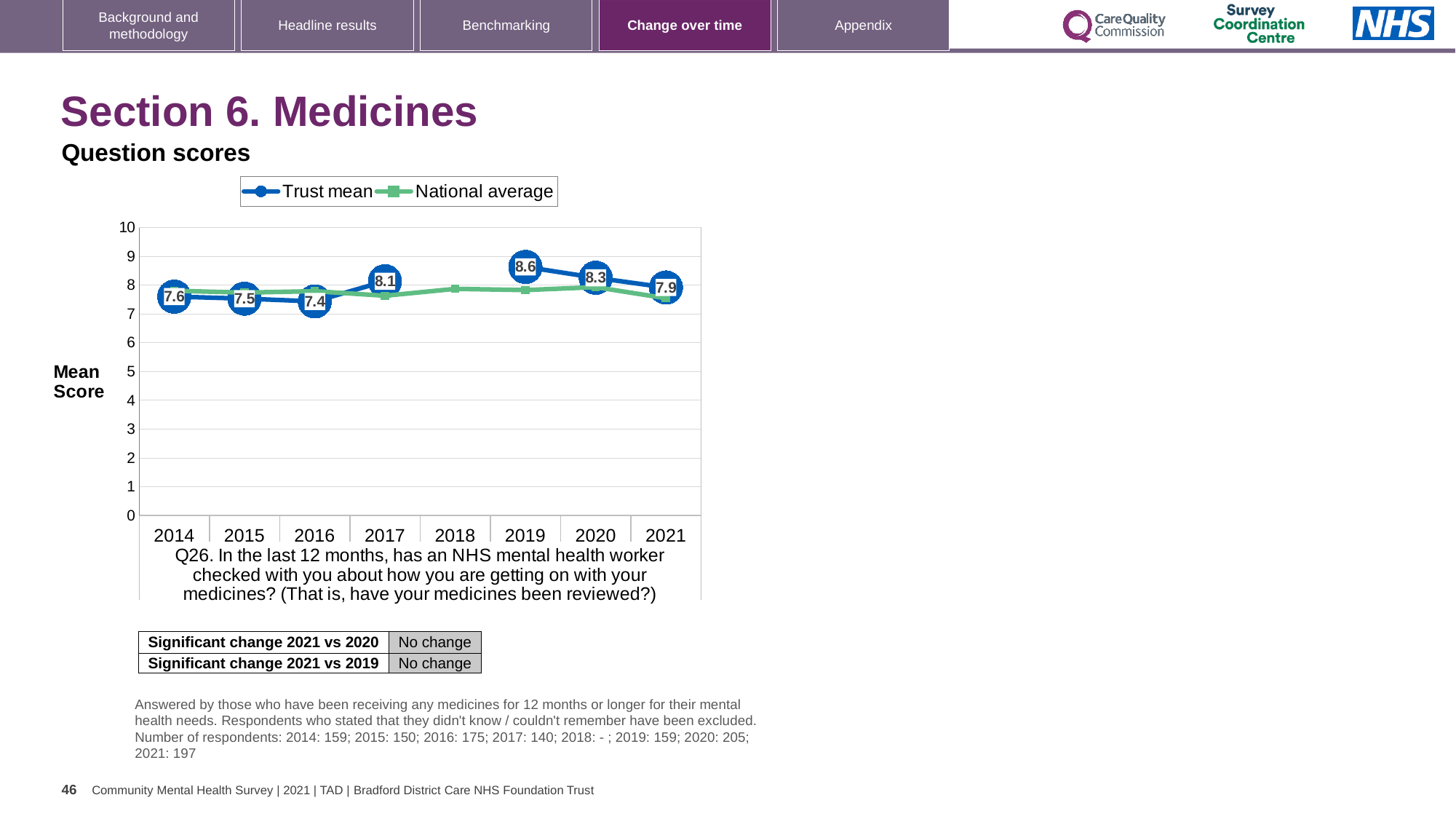
What is the Trust mean score for 2021? 7.9 What is the Trust mean score for 2016? 7.4 What is the Trust mean score for 2019? 8.6 In which year is the Trust mean score highest? 2019 How many years are shown on the x axis? 8 In which year is the Trust mean score lowest? 2016 What kind of chart is shown on the slide? Line chart What is the difference between the Trust mean scores for 2019 and 2016? 1.2 What is the difference between the Trust mean scores for 2020 and 2021? 0.4 How many series does the legend list? 2 Is the National average value for 2018 greater or less than 7? greater Which is larger, the Trust mean score for 2017 or for 2015? 2017